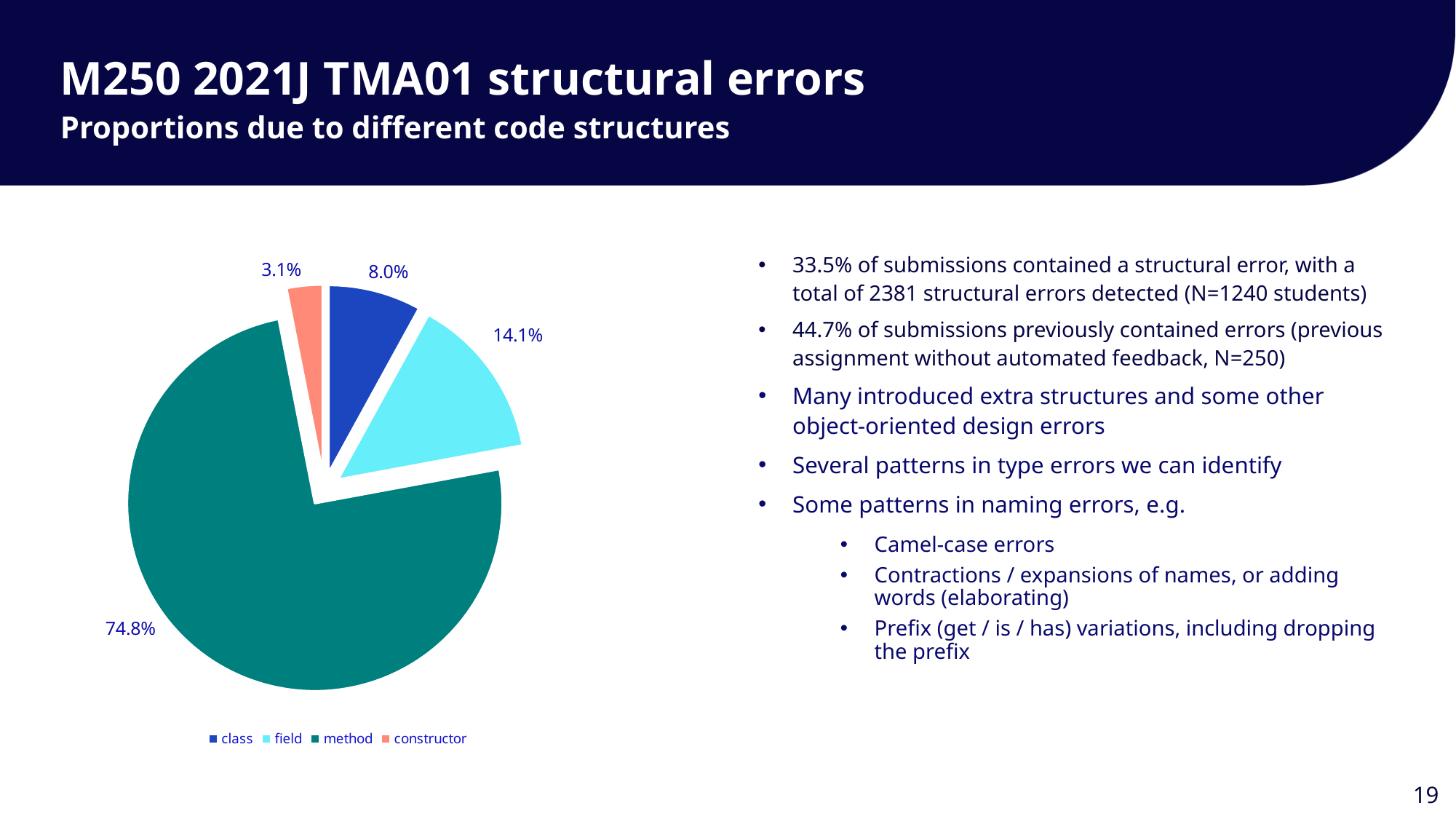
Which code structure accounts for the largest share of structural errors? method What percentage of structural errors is due to methods? 74.8% What percentage of structural errors is due to fields? 14.1% Which colour represents the method category in the pie chart? dark teal What kind of chart is shown on the slide? pie chart What is the combined share of the class and constructor slices? 11.1% Which code structure accounts for the smallest share of structural errors? constructor Which has a larger share of structural errors, field or class? field What percentage of structural errors is due to classes? 8.0% How many code structure categories does the pie chart show? 4 What percentage of structural errors is due to constructors? 3.1% What is the difference in percentage points between the field share and the class share? 6.1